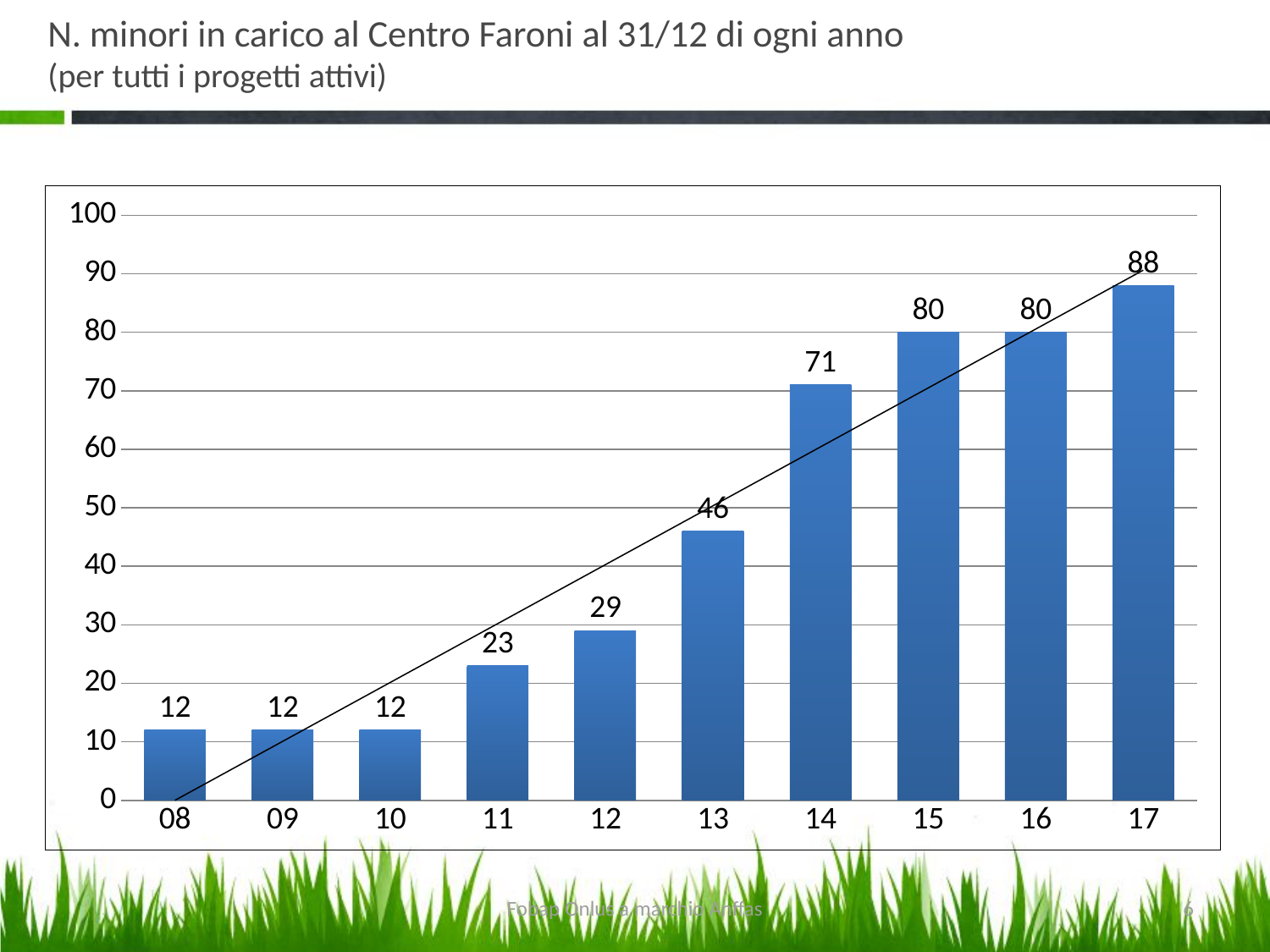
What is the difference between the values for 14 and 13? 25 What is the value for 17? 88 How many years are shown on the x axis? 10 Do the values generally rise or fall from 08 to 17? rise What is the value for 14? 71 Which is larger, the value for 12 or the value for 13? 13 Is the value for 15 greater or less than 70? greater What is the difference between the values for 17 and 16? 8 What is the value for 11? 23 What kind of chart is this? bar chart Which year has the highest value? 17 What is the title of the slide? N. minori in carico al Centro Faroni al 31/12 di ogni anno (per tutti i progetti attivi)